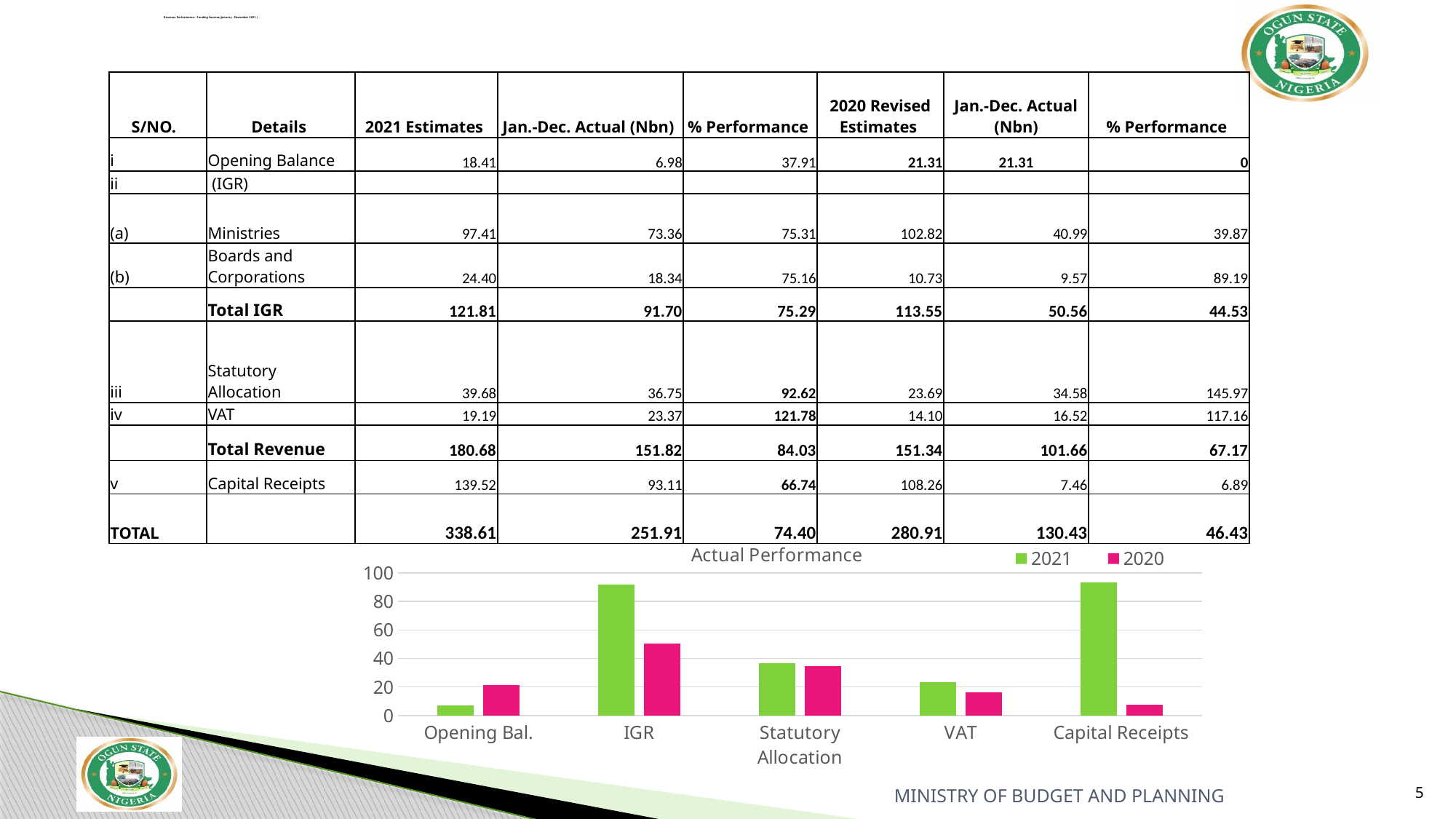
Which category has the highest 2020 value in the chart? IGR Which category has the lowest 2020 value in the chart? Capital Receipts Is the 2020 value for Capital Receipts greater or less than 20? less How many categories are shown on the x axis of the chart? 5 Is the 2021 value for Statutory Allocation greater or less than 60? less Which category has the lowest 2021 value in the chart? Opening Bal. What kind of chart is shown on the slide? bar chart For Opening Bal., which series has the larger value, 2021 or 2020? 2020 For Capital Receipts, which series has the larger value, 2021 or 2020? 2021 How many series does the chart legend list? 2 Is the 2021 value for IGR greater or less than 80? greater What is the title of the chart? Actual Performance